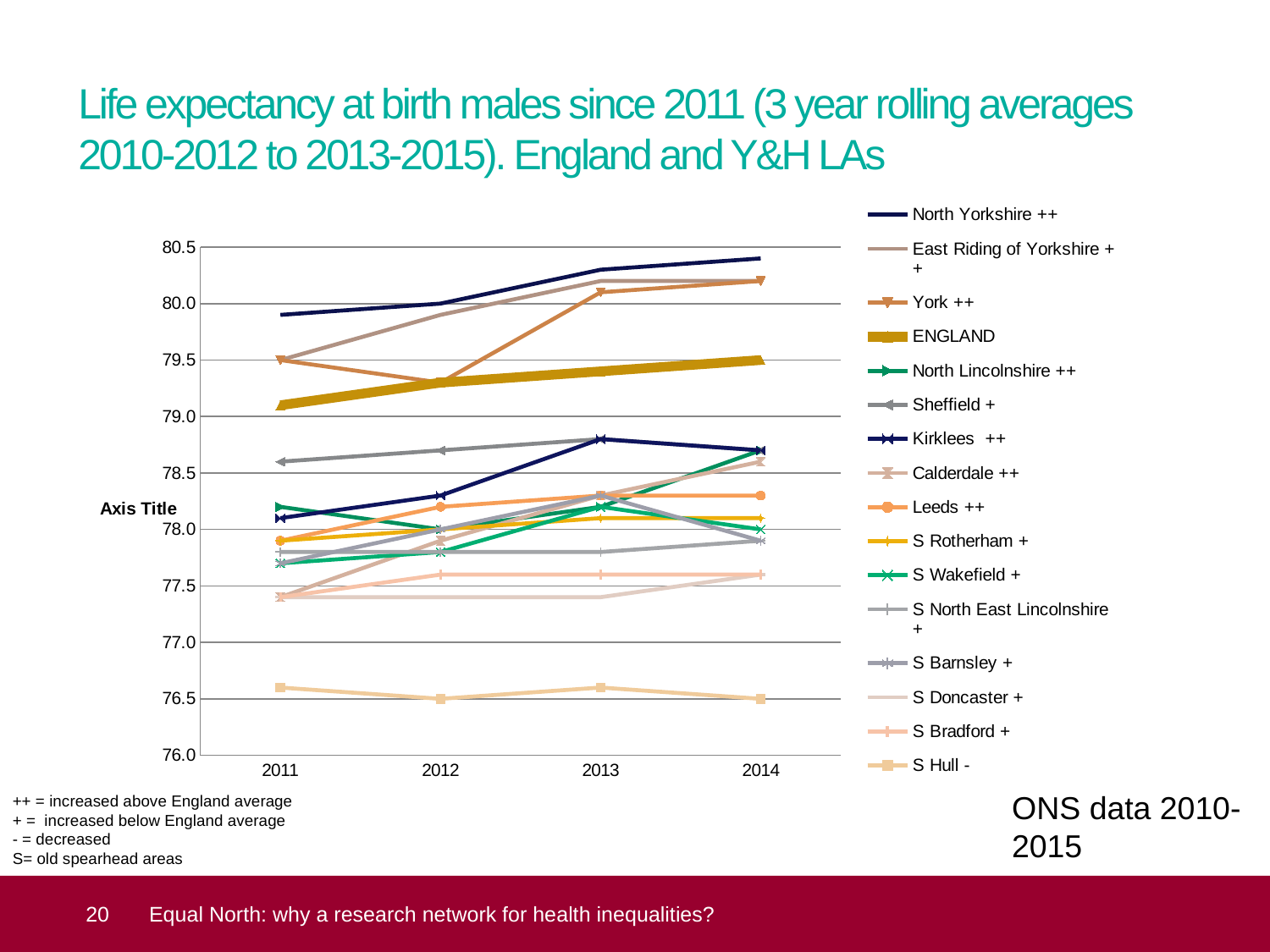
In 2013, which is higher: York ++ or ENGLAND? York ++ Which area has the lowest life expectancy in 2014? S Hull - Which area has the highest life expectancy in 2014? North Yorkshire ++ In 2011, which is higher: Sheffield + or Kirklees ++? Sheffield + Is the value for North Yorkshire ++ in 2014 greater or less than 80.0? greater Is the value for ENGLAND in 2011 greater or less than 79.5? less What kind of chart is shown on the slide? line chart Is the value for S Hull - in 2011 greater or less than 77.0? less How many years are shown on the x axis? 4 How many series does the legend list? 16 What is the value for S Hull - in 2012? 76.5 Does the ENGLAND line rise or fall from 2011 to 2014? rise